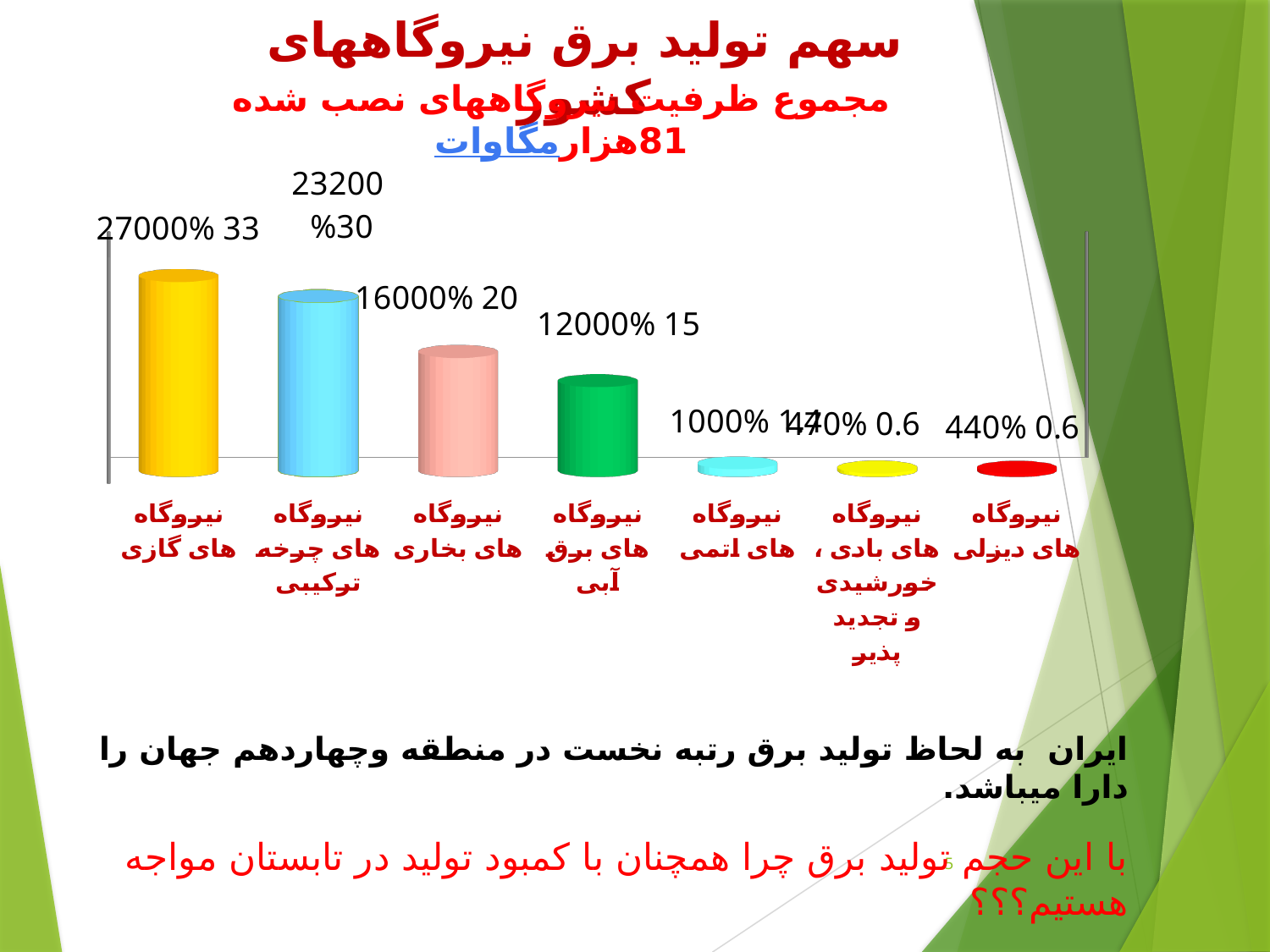
How many power plant categories are plotted in the chart? 7 Which is larger, the value for نیروگاه های بخاری or the value for نیروگاه های برق آبی? نیروگاه های بخاری Do the values rise or fall moving from left to right across the chart? fall What value is labelled for نیروگاه های برق آبی (hydroelectric power plants)? 12000 Which category has the highest value in the chart? نیروگاه های گازی What is the difference between the values for نیروگاه های گازی and نیروگاه های چرخه ترکیبی? 3800 What kind of chart is shown on the slide? bar chart What value is labelled for نیروگاه های چرخه ترکیبی (combined cycle power plants)? 23200 What colour is the bar for نیروگاه های گازی? yellow What value is labelled for نیروگاه های بخاری (steam power plants)? 16000 What value is labelled for نیروگاه های گازی (gas power plants)? 27000 What value is labelled for نیروگاه های دیزلی (diesel power plants)? 440